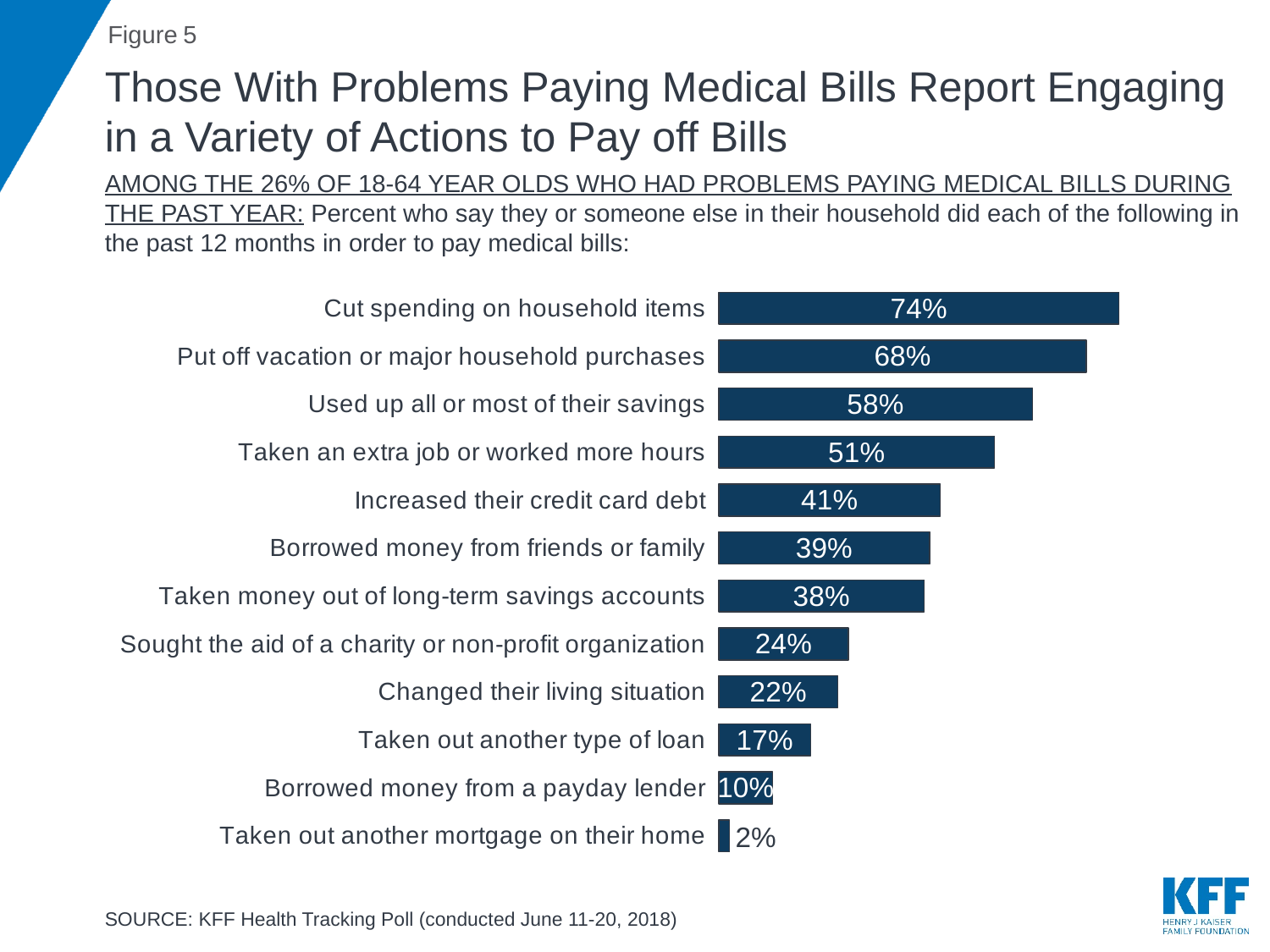
What kind of chart is shown on the slide? Bar chart How many actions are shown in the chart? 12 Which is larger: the percent who put off vacation or major household purchases or the percent who taken money out of long-term savings accounts? Put off vacation or major household purchases Which action has the lowest percentage? Taken out another mortgage on their home What is the difference between the percent who used up all or most of their savings and the percent who taken an extra job or worked more hours? 7 percentage points What percent say they increased their credit card debt? 41% What is the source of the data shown in the chart? KFF Health Tracking Poll (conducted June 11-20, 2018) What percent say they borrowed money from a payday lender? 10% Which action has the highest percentage? Cut spending on household items What percent say they cut spending on household items? 74% Which is larger: the percent who borrowed money from friends or family or the percent who changed their living situation? Borrowed money from friends or family What is the difference between the percent who sought the aid of a charity or non-profit organization and the percent who taken out another type of loan? 7 percentage points